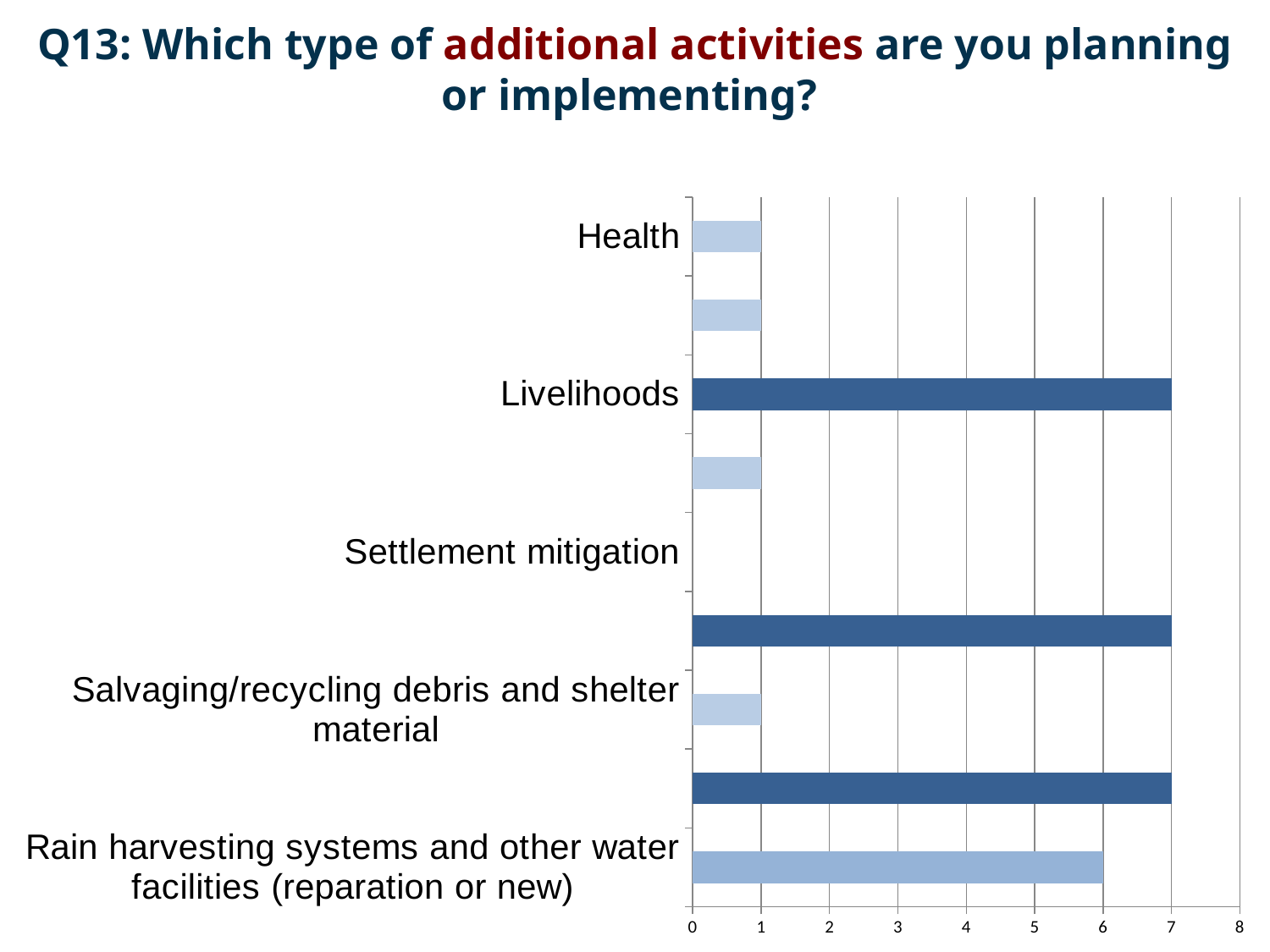
Which labelled category has the highest value? Livelihoods What is the value for Health? 1 What is the difference between the values for Livelihoods and Rain harvesting systems and other water facilities? 1 Which labelled category has the lowest value? Settlement mitigation What colour is the bar for Livelihoods? Dark blue Is the value for Rain harvesting systems and other water facilities greater or less than 5? greater Which is larger, the value for Rain harvesting systems and other water facilities or the value for Health? Rain harvesting systems and other water facilities What is the maximum value shown on the horizontal axis? 8 What kind of chart is shown on the slide? Bar chart What is the value for Rain harvesting systems and other water facilities (reparation or new)? 6 What is the value for Salvaging/recycling debris and shelter material? 1 What is the value for Livelihoods? 7